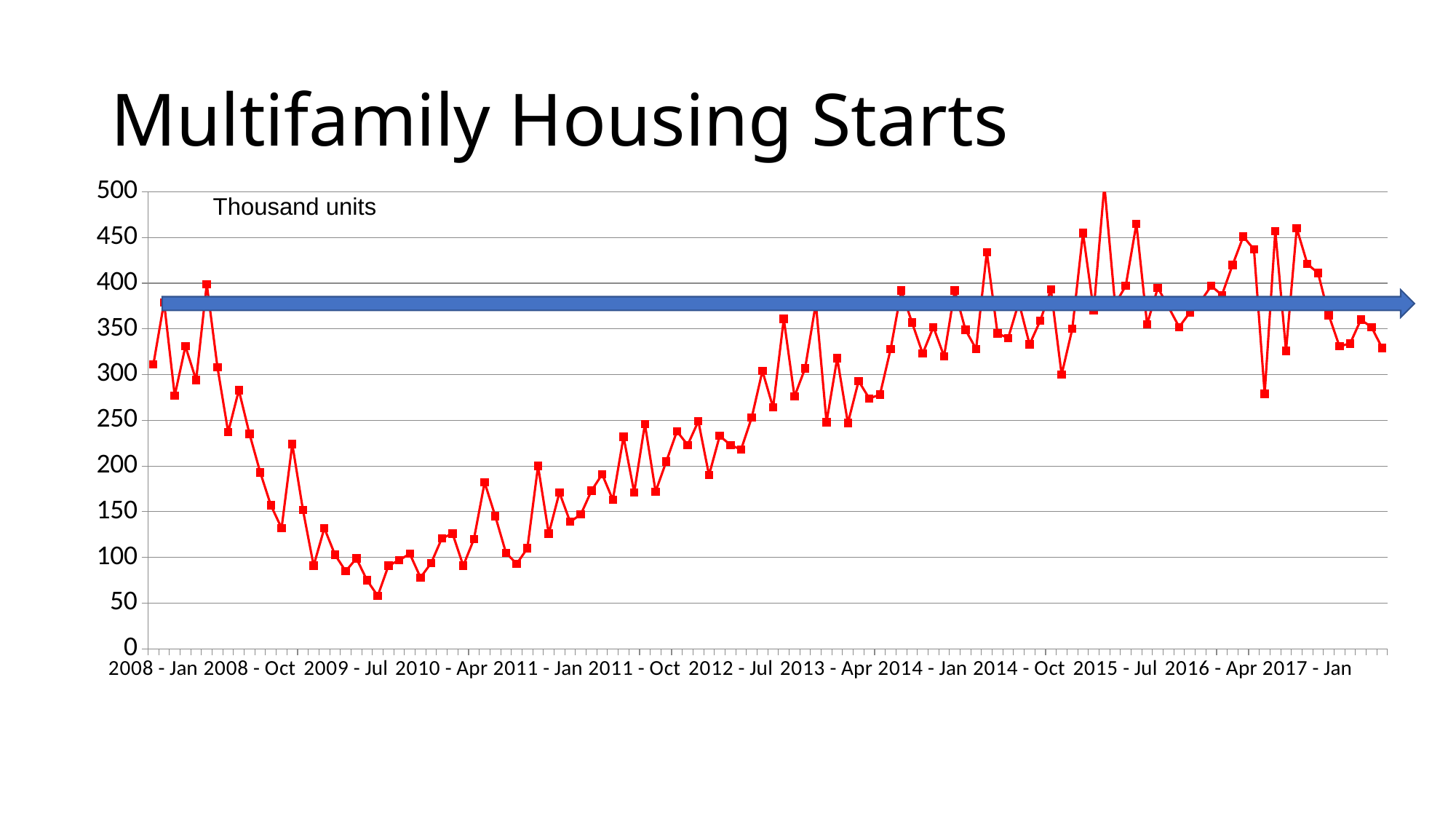
What is the title of the chart on the slide? Multifamily Housing Starts Is the value for 2016 - Apr greater or less than 300? greater Is the highest value plotted on the chart greater or less than 450? greater Which is larger, the value for 2009 - Jul or the value for 2015 - Jul? 2015 - Jul Do the values generally rise or fall between 2009 - Jul and 2014 - Jan? rise What unit label is printed inside the chart area? Thousand units Is the value for 2009 - Jul greater or less than 150? less What kind of chart is shown on the slide? line chart